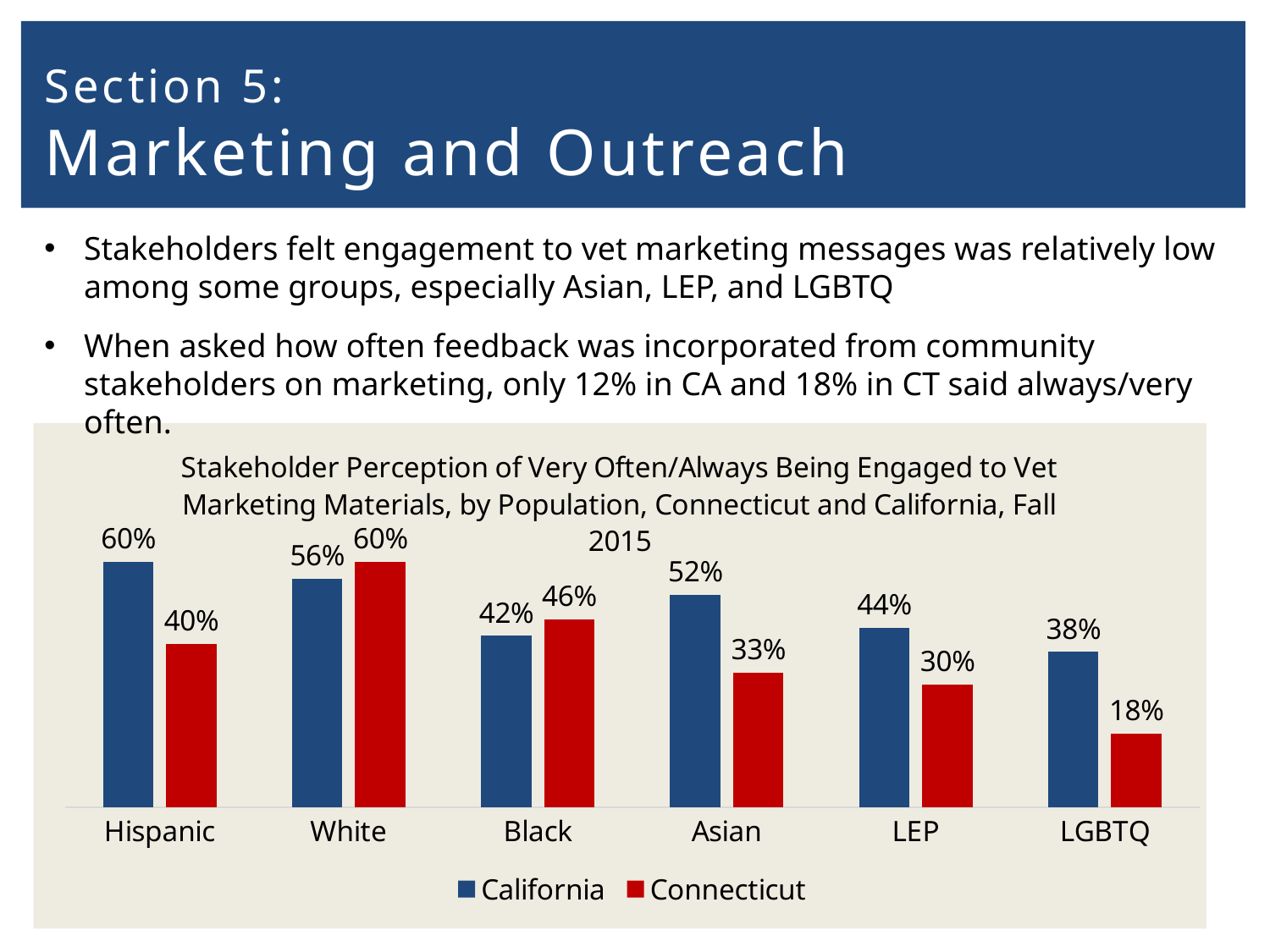
Which is larger for White, the California value or the Connecticut value? Connecticut What kind of chart is shown on the slide? Bar chart What is the Connecticut value for Black? 46% How many population groups are shown on the x axis? 6 How many series does the legend list? 2 What is the California value for Hispanic? 60% What is the Connecticut value for LGBTQ? 18% What is the difference between the California and Connecticut values for LGBTQ? 20% Which is larger for LEP, the California value or the Connecticut value? California Which population has the highest California value? Hispanic What is the difference between the California and Connecticut values for Asian? 19% Which population has the lowest Connecticut value? LGBTQ